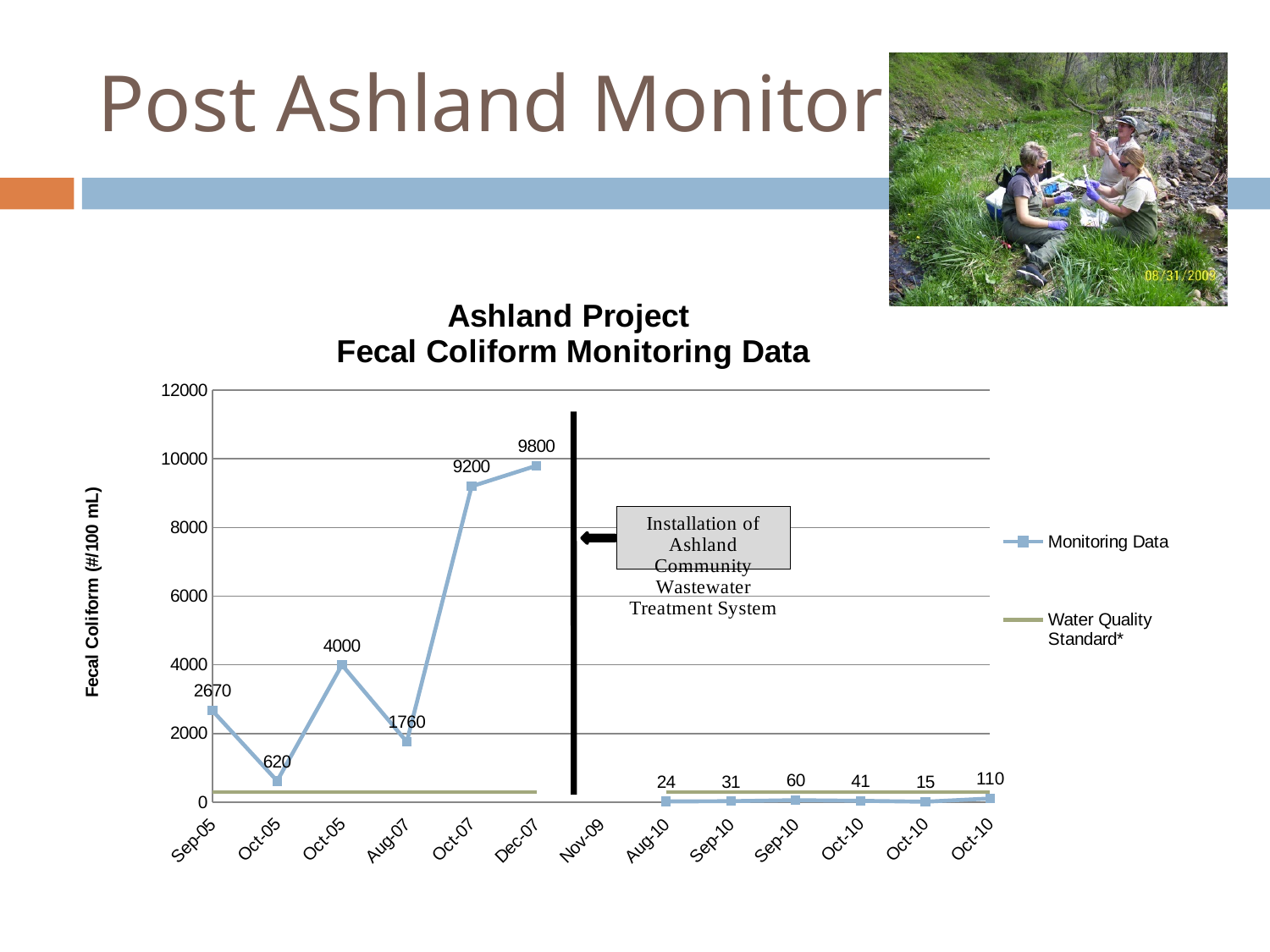
Which date has the highest Monitoring Data value? Dec-07 What is the title of the vertical axis? Fecal Coliform (#/100 mL) Is the Monitoring Data value for Oct-07 greater or less than 8000? greater What is the Monitoring Data value for Aug-07? 1760 What is the lowest Monitoring Data value labelled on the chart? 15 What is the Monitoring Data value for Aug-10? 24 What is the Monitoring Data value for Dec-07? 9800 What kind of chart is shown on the slide? line chart What is the difference between the Monitoring Data values for Dec-07 and Oct-07? 600 How many series does the legend list? 2 Which has the larger Monitoring Data value, Sep-05 or Aug-07? Sep-05 What is the Monitoring Data value for Sep-05? 2670